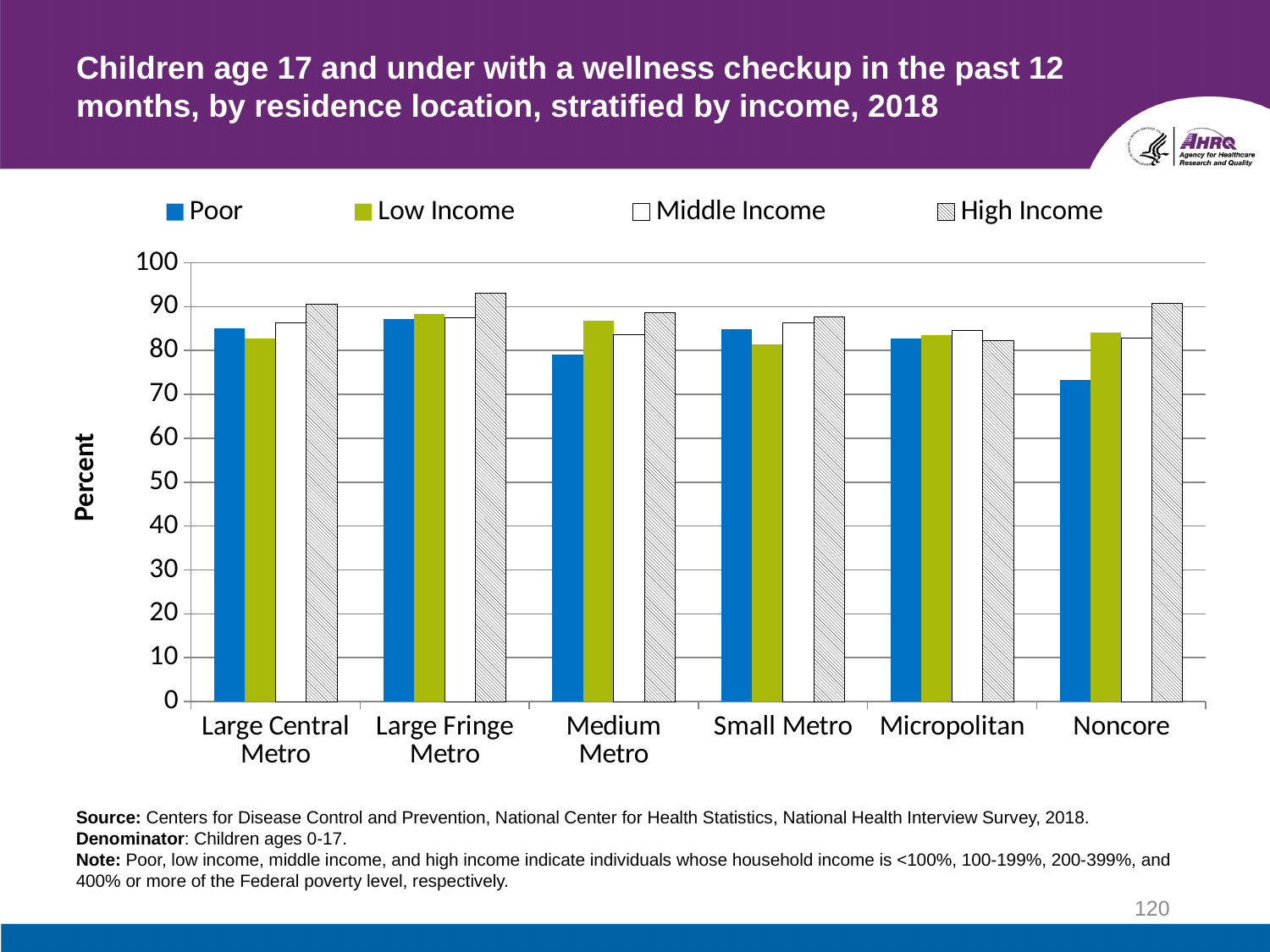
Which residence location has the lowest value for the Poor group? Noncore Which income group is shown with solid blue bars? Poor In Noncore, which is larger: the Poor value or the High Income value? High Income Is the value for the High Income group in Large Fringe Metro greater or less than 90? greater In Medium Metro, which is larger: the Poor value or the Low Income value? Low Income Is the value for the Low Income group in Small Metro greater or less than 90? less What is the label on the y axis? Percent Which residence location has the highest value for the High Income group? Large Fringe Metro How many income groups does the legend list? 4 What kind of chart is shown on the slide? Bar chart How many residence location categories are shown on the x axis? 6 Is the value for the Poor group in Noncore greater or less than 80? less